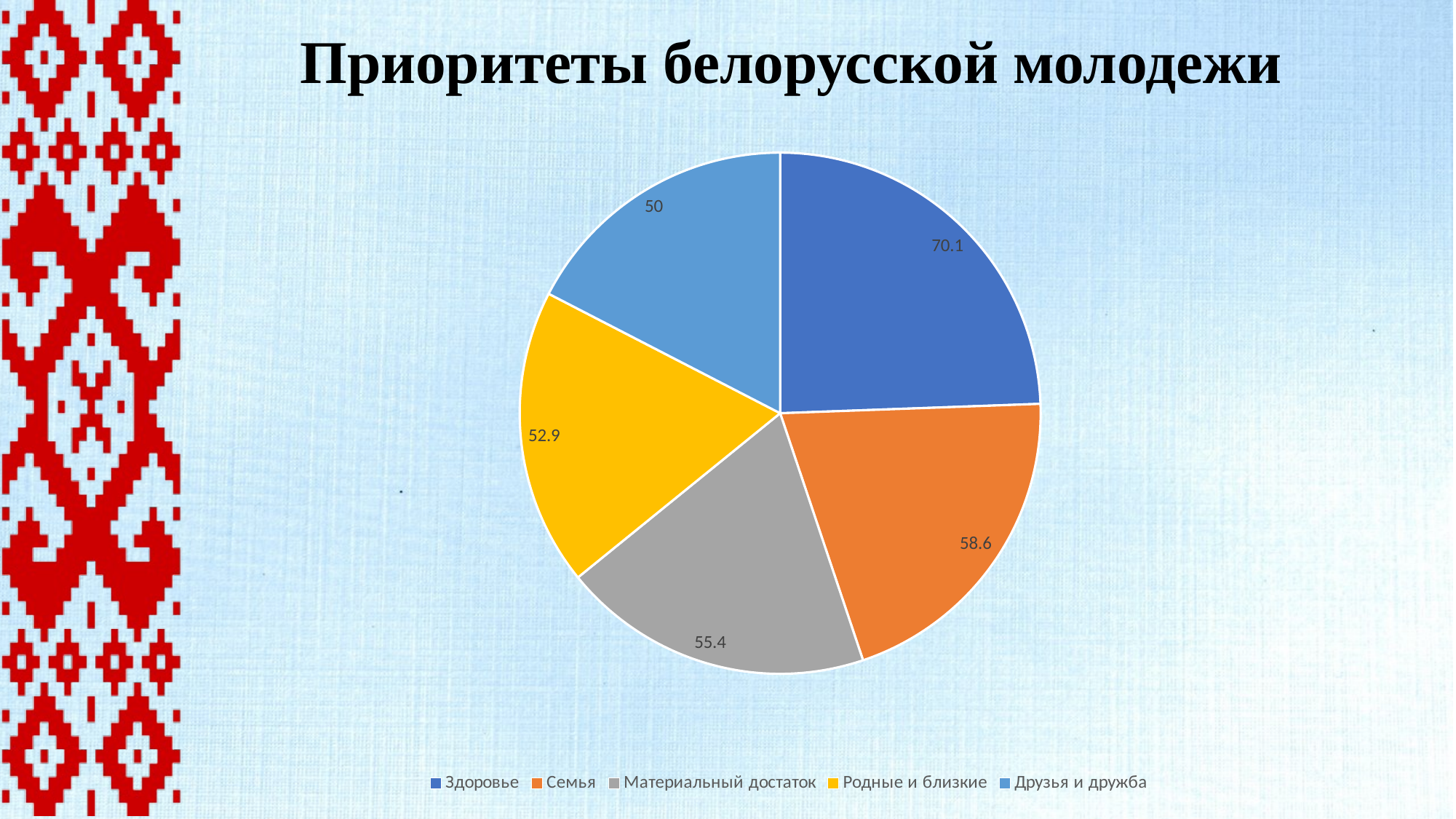
What is the value for Друзья и дружба? 50 What is the value for Семья? 58.6 What is the value for Родные и близкие? 52.9 How many slices does the pie chart have? 5 What is the value for Здоровье? 70.1 What is the value for Материальный достаток? 55.4 Which category has the lowest value? Друзья и дружба Which category has the highest value? Здоровье What is the difference between the values for Здоровье and Семья? 11.5 Which is larger, the value for Семья or the value for Родные и близкие? Семья What is the title of the chart? Приоритеты белорусской молодежи What kind of chart is shown on the slide? pie chart